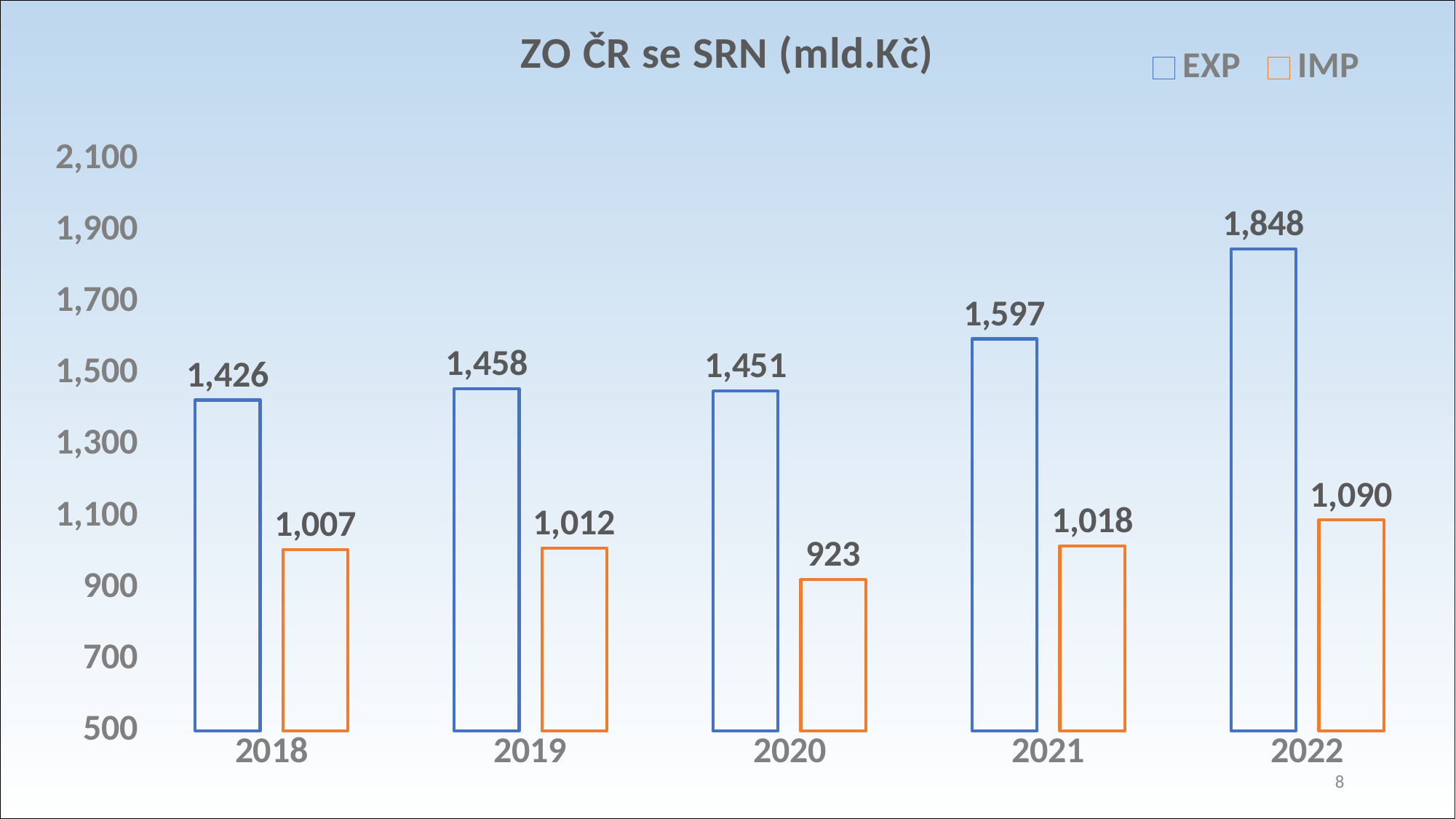
Which year has the lowest IMP value? 2020 Is the EXP value for 2021 greater or less than 1,500? greater What is the difference between EXP and IMP in 2021? 579 How many years are shown on the x axis? 5 Which is larger, the IMP value for 2018 or the IMP value for 2022? IMP value for 2022 Which year has the highest EXP value? 2022 What is the EXP value for 2019? 1,458 How many series does the legend list? 2 What is the EXP value for 2022? 1,848 What is the title of the chart? ZO ČR se SRN (mld.Kč) What kind of chart is shown on the slide? bar chart What is the IMP value for 2020? 923